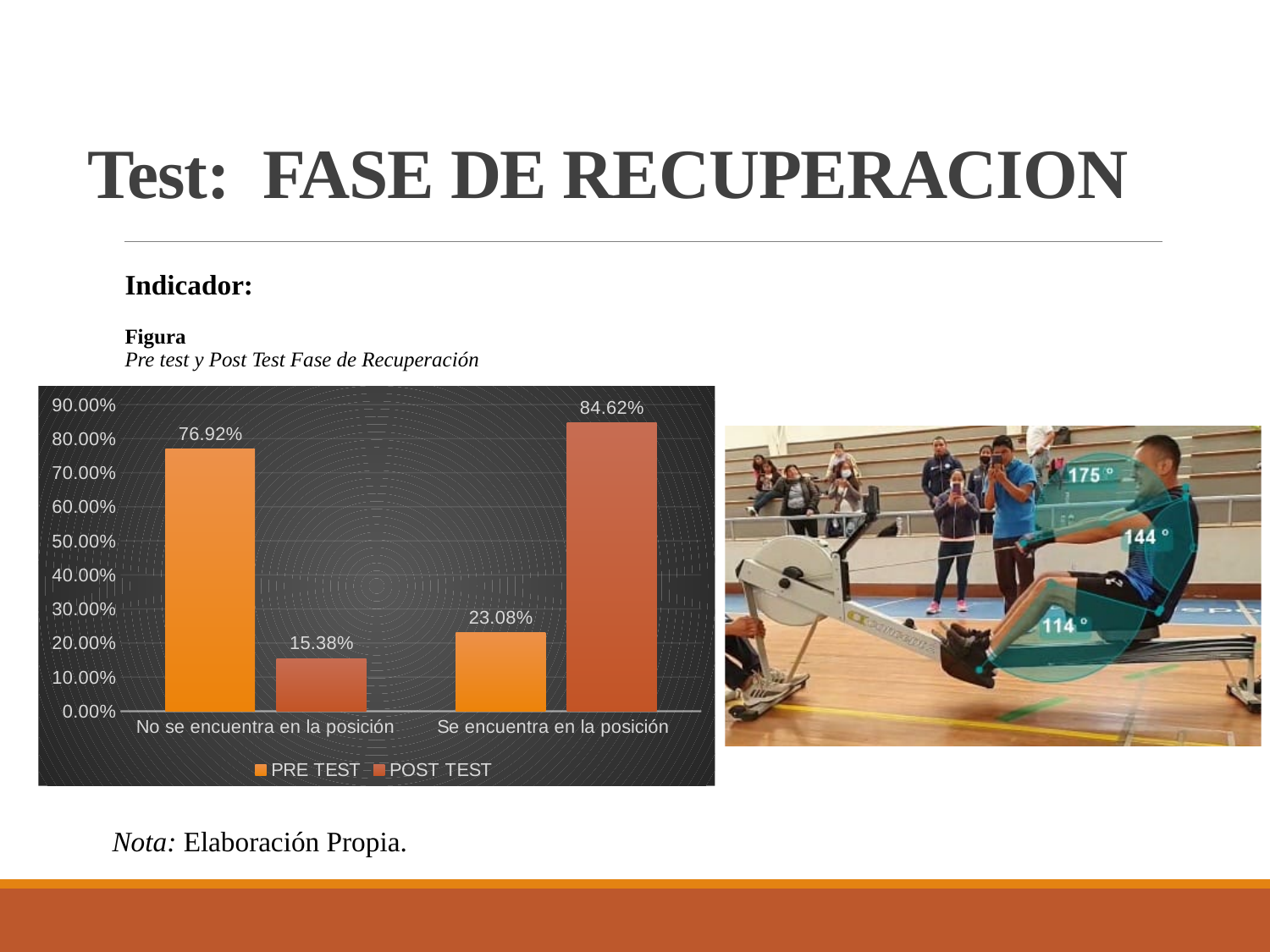
What is the PRE TEST value for "Se encuentra en la posición"? 23.08% What is the PRE TEST value for "No se encuentra en la posición"? 76.92% Which category has the highest POST TEST value? Se encuentra en la posición What is the POST TEST value for "Se encuentra en la posición"? 84.62% Which is larger for "No se encuentra en la posición": the PRE TEST or the POST TEST value? PRE TEST What are the two series named in the chart legend? PRE TEST and POST TEST Which category has the lowest PRE TEST value? Se encuentra en la posición What kind of chart is shown on the slide? Bar chart What is the difference between the POST TEST and PRE TEST values for "Se encuentra en la posición"? 61.54% How many categories are shown on the x axis of the chart? 2 How many series does the chart legend list? 2 What is the POST TEST value for "No se encuentra en la posición"? 15.38%